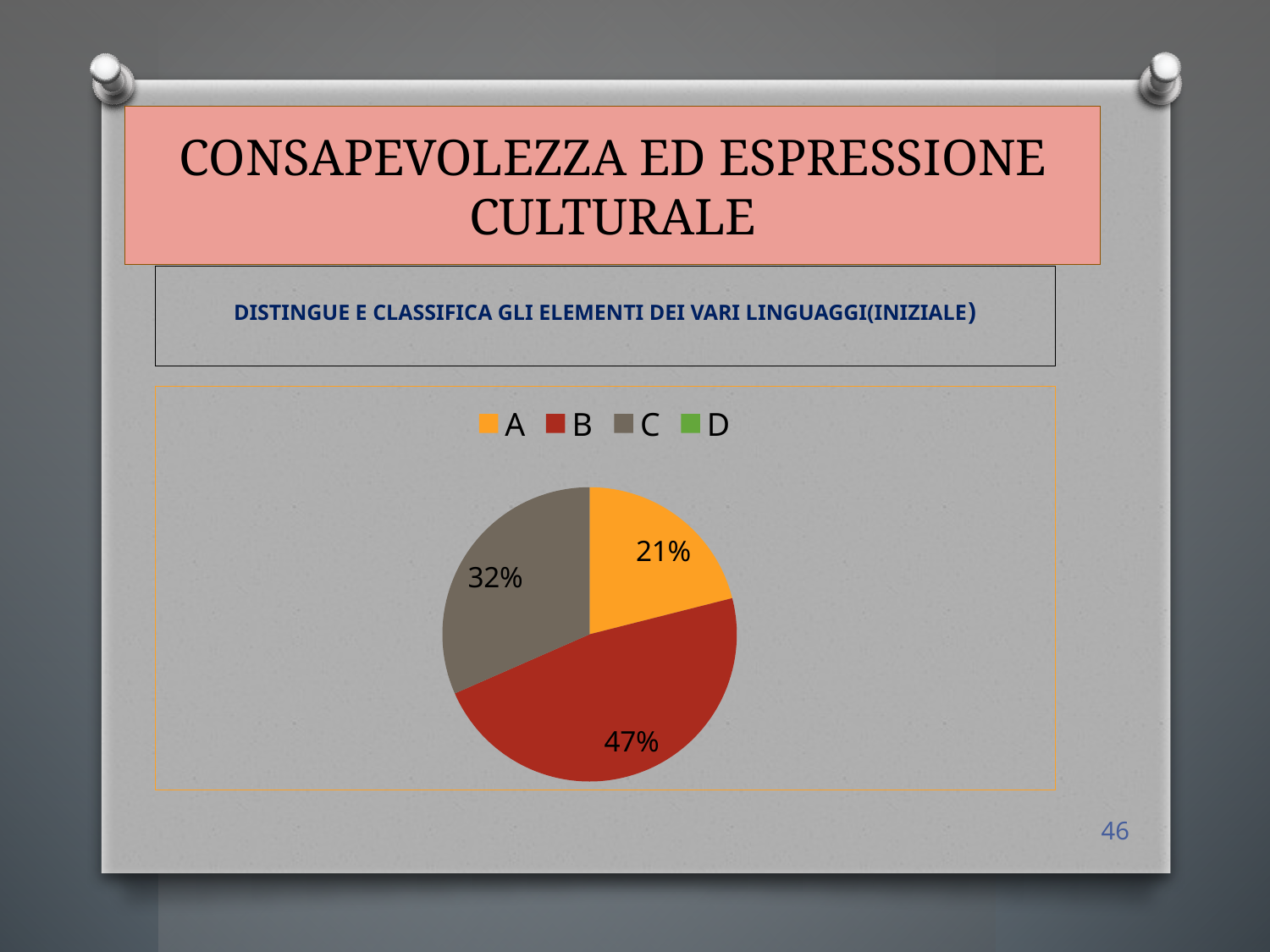
Which is larger, slice B or slice C? B How many entries does the chart legend list? 4 What percentage does slice B represent in the pie chart? 47% Which category has the largest slice in the pie chart? B What percentage does slice C represent in the pie chart? 32% How many slices with data labels are visible in the pie chart? 3 What type of chart is shown on the slide? pie chart What is the difference in percentage points between slice C and slice A? 11 What is the difference in percentage points between slice B and slice A? 26 Which labelled slice is the smallest in the pie chart? A What colour is slice B in the pie chart? red What percentage does slice A represent in the pie chart? 21%